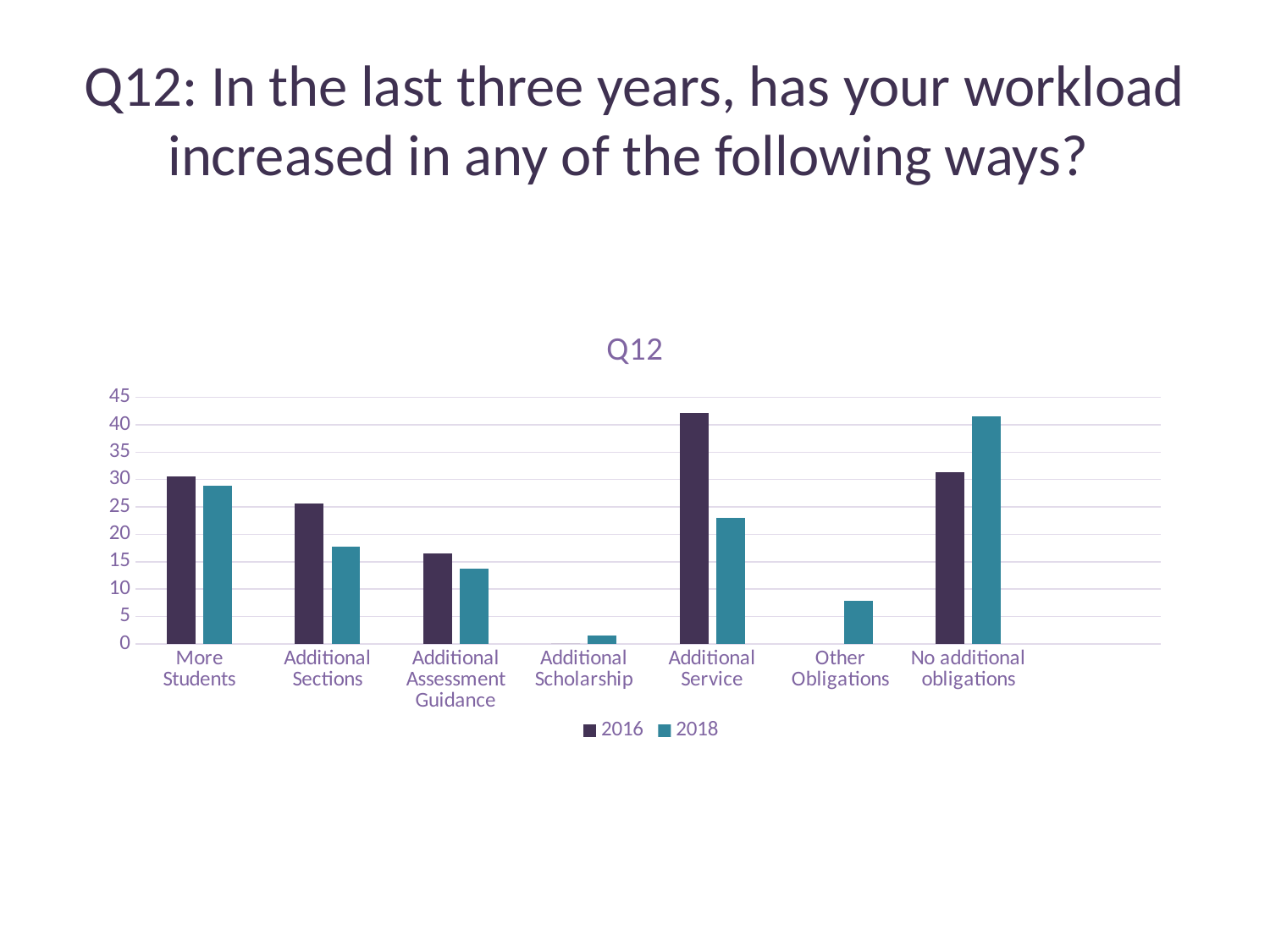
For No additional obligations, which series has the larger value, 2016 or 2018? 2018 Is the 2018 value for Other Obligations greater or less than 10? less Which category has the lowest value for the 2018 series? Additional Scholarship For Additional Service, which series has the larger value, 2016 or 2018? 2016 What is the title of the chart? Q12 Which category has the highest value for the 2016 series? Additional Service How many series does the legend list? 2 What kind of chart is shown on the slide? bar chart Is the 2016 value for Additional Service greater or less than 35? greater Is the 2018 value for Additional Sections greater or less than 20? less Which category has the highest value for the 2018 series? No additional obligations How many categories are shown on the x axis of the chart? 7